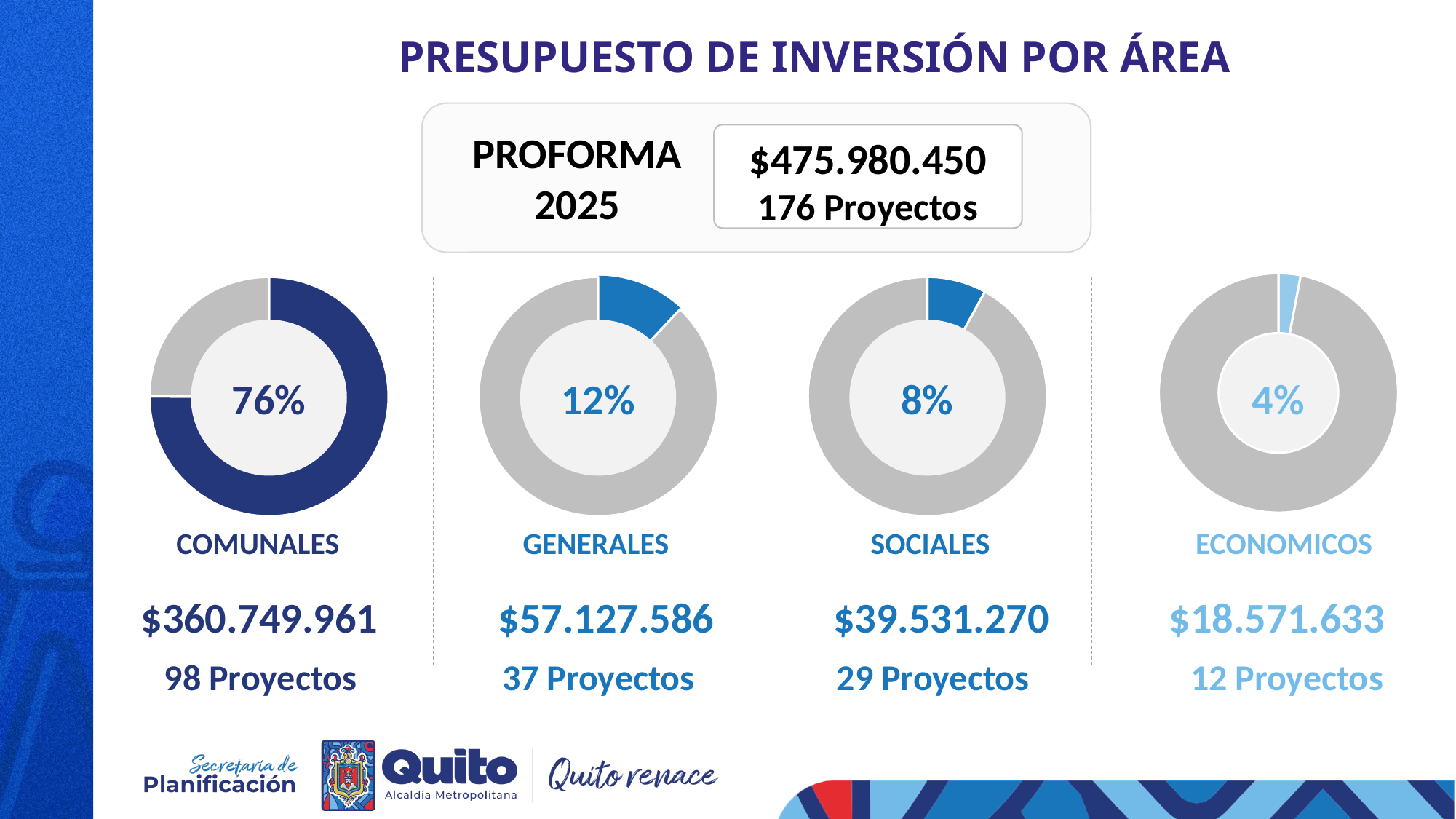
What kind of chart is used to show each area's share? Donut chart What percentage is shown in the ECONOMICOS donut chart? 4% What is the budget amount shown below the SOCIALES donut chart? $39.531.270 Which area has the largest share of the investment budget? COMUNALES How many donut charts are shown on the slide? 4 Which has a larger share, SOCIALES or ECONOMICOS? SOCIALES Which area has the smallest share of the investment budget? ECONOMICOS What percentage is shown in the COMUNALES donut chart? 76% What percentage is shown in the SOCIALES donut chart? 8% How many projects are listed under the GENERALES donut chart? 37 Proyectos What percentage is shown in the GENERALES donut chart? 12% What is the difference in percentage points between the COMUNALES and GENERALES shares? 64